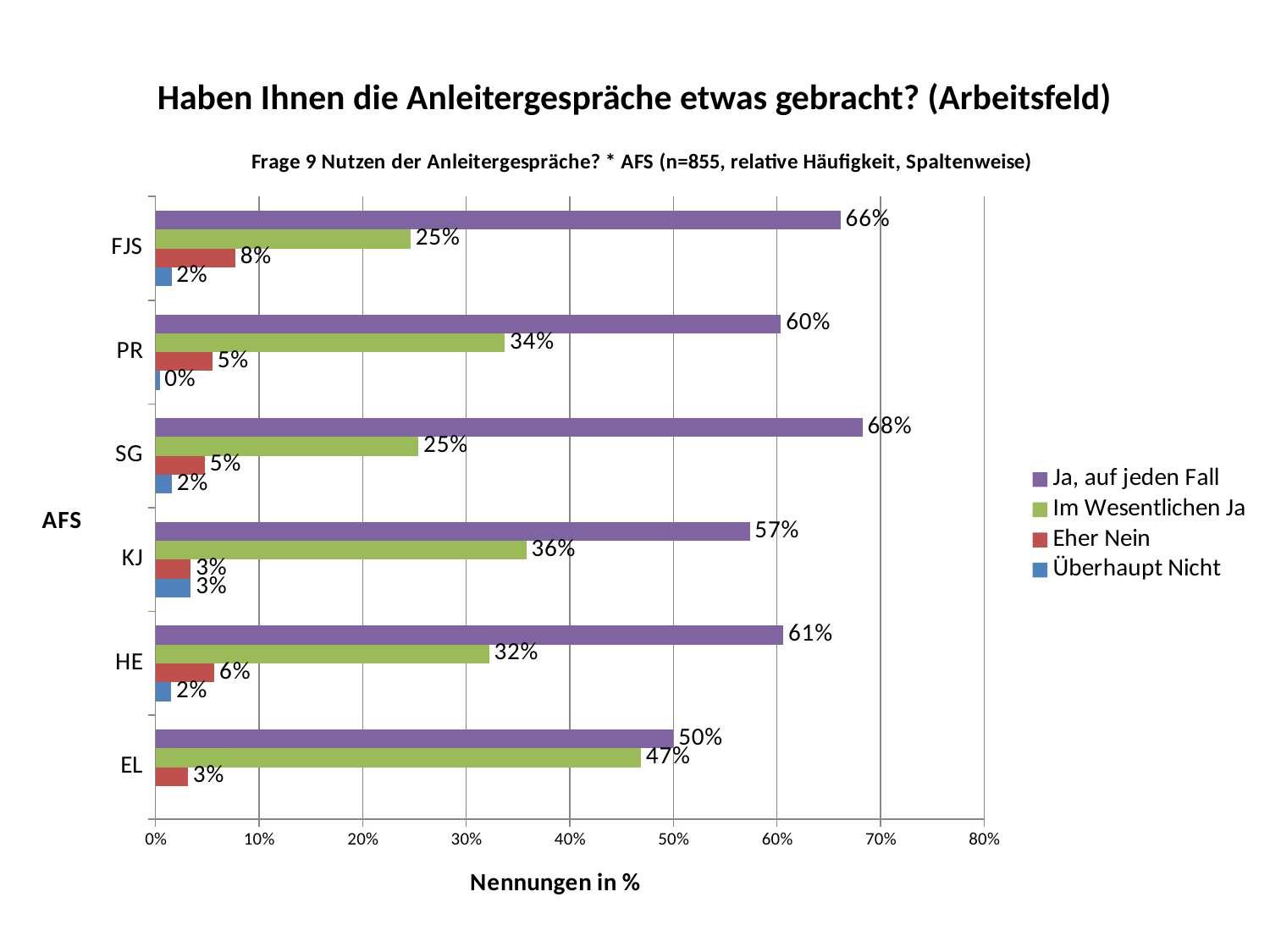
What kind of chart is shown on the slide? bar chart What is the value for "Eher Nein" in the FJS category? 8% What is the difference between the "Ja, auf jeden Fall" values for SG and EL? 18% How many series does the legend list? 4 How many categories (Arbeitsfelder) are shown on the vertical axis? 6 What is the value for "Im Wesentlichen Ja" in the EL category? 47% Which category has the highest value for "Ja, auf jeden Fall"? SG What is the label of the horizontal axis? Nennungen in % What is the value for "Ja, auf jeden Fall" in the SG category? 68% Which is larger: the "Im Wesentlichen Ja" value for KJ or for PR? KJ Which category has the lowest value for "Ja, auf jeden Fall"? EL What is the value for "Überhaupt Nicht" in the PR category? 0%